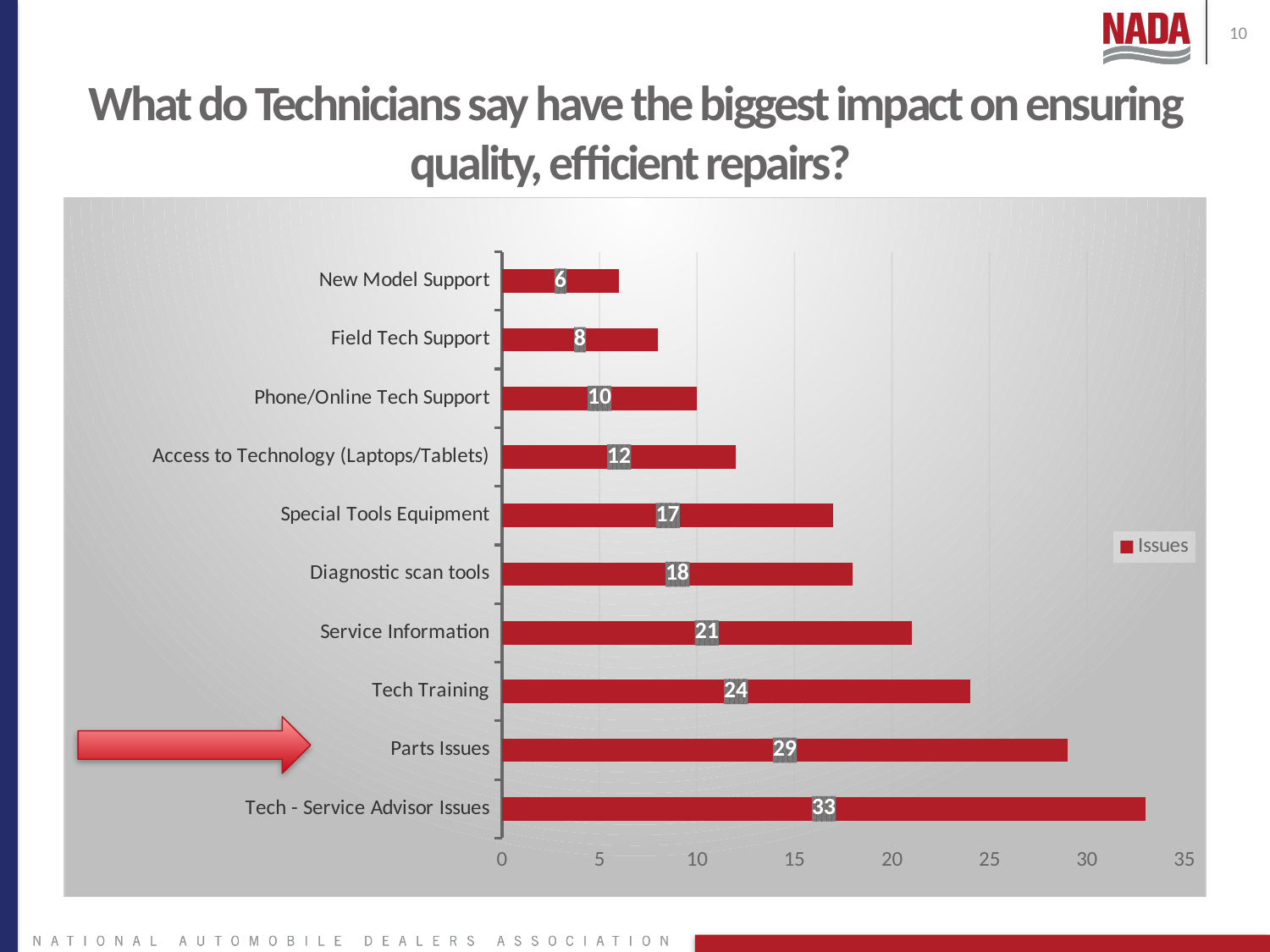
What is the difference between Tech - Service Advisor Issues and Parts Issues? 4 What is the value for Diagnostic scan tools? 18 How many categories are shown in the chart? 10 Which category has the lowest value? New Model Support Is the value for Phone/Online Tech Support greater or less than 15? less Which category has the highest value? Tech - Service Advisor Issues What is the difference between Tech Training and Service Information? 3 What is the value for New Model Support? 6 How many series does the legend list? 1 Which is larger, Special Tools Equipment or Access to Technology (Laptops/Tablets)? Special Tools Equipment What kind of chart is shown on the slide? bar chart What is the value for Parts Issues? 29